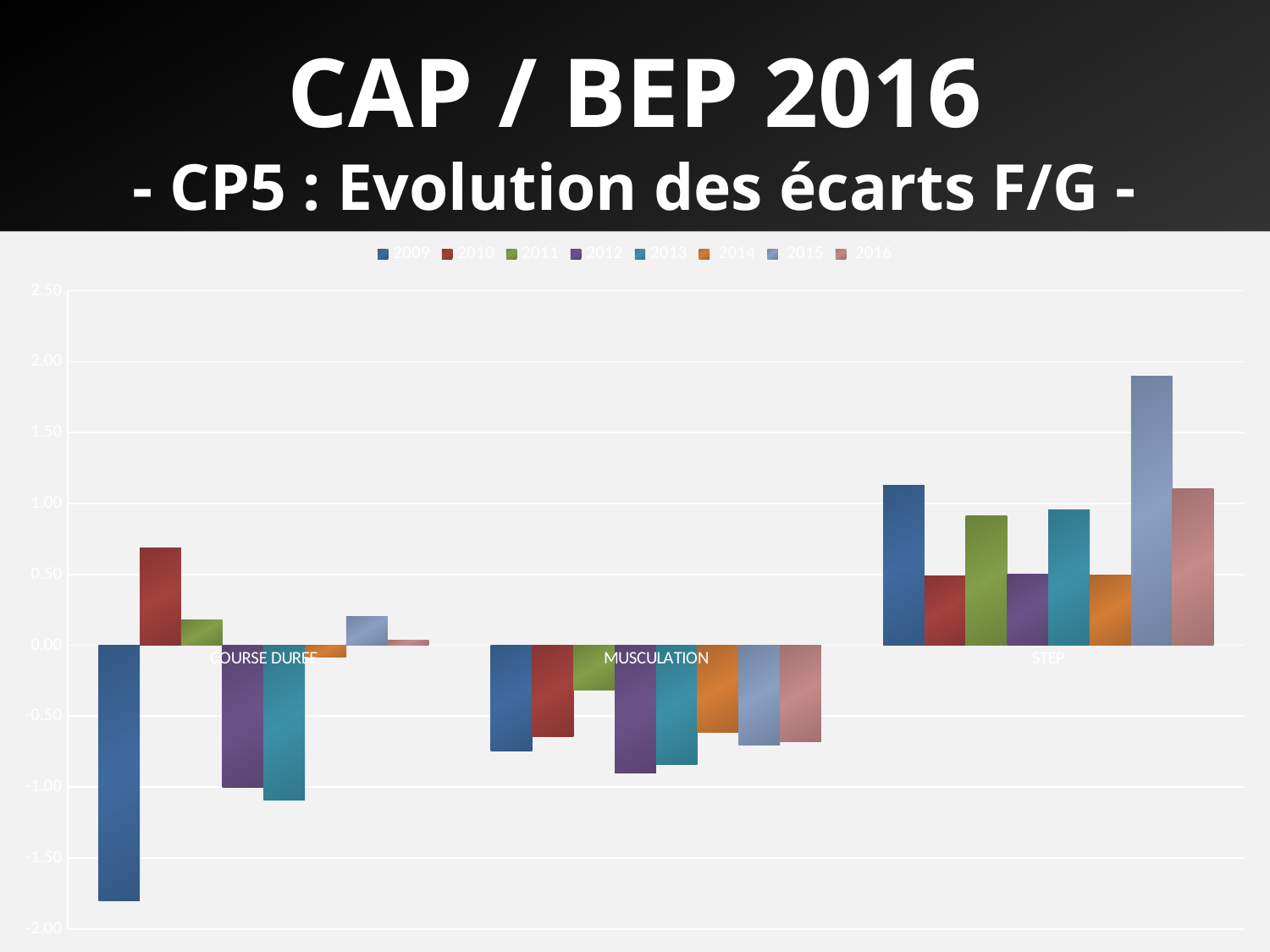
How many series does the chart's legend list? 8 How many categories are shown on the x axis of the chart? 3 Which series has the highest value in the STEP category? 2015 Is the value for 2012 in the MUSCULATION category greater or less than -0.50? less Which category has the lowest bar in the chart? COURSE DUREE Which category has the highest bar in the chart? STEP Which series has the lowest value in the COURSE DUREE category? 2009 Is the value for 2009 in the COURSE DUREE category greater or less than -1.50? less What kind of chart is shown on the slide? bar chart Which series is listed first in the chart's legend? 2009 Which is larger in the STEP category, the value for 2009 or the value for 2010? 2009 Is the value for 2015 in the STEP category greater or less than 1.50? greater